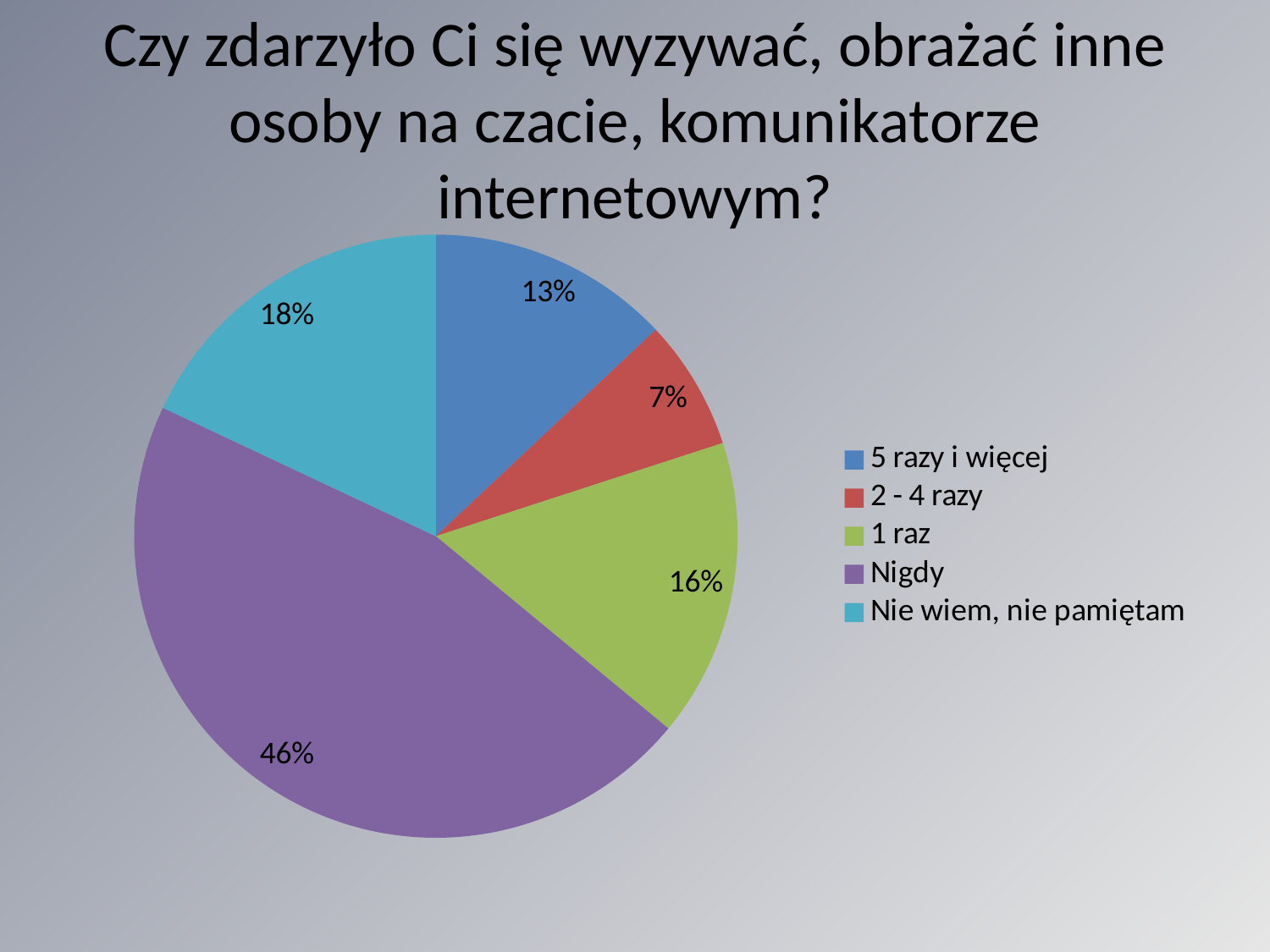
What share of the pie does "Nigdy" take? 46% Which is larger, the value for "1 raz" or the value for "5 razy i więcej"? 1 raz Which category has the largest slice? Nigdy What is the value for "5 razy i więcej"? 13% What colour is the slice for "Nigdy"? purple Which category has the smallest slice? 2 - 4 razy What is the value for "2 - 4 razy"? 7% What is the value for "Nie wiem, nie pamiętam"? 18% What kind of chart is shown on the slide? pie chart What is the value for "1 raz"? 16% How many categories does the legend list? 5 What is the difference between the values for "Nigdy" and "Nie wiem, nie pamiętam"? 28%